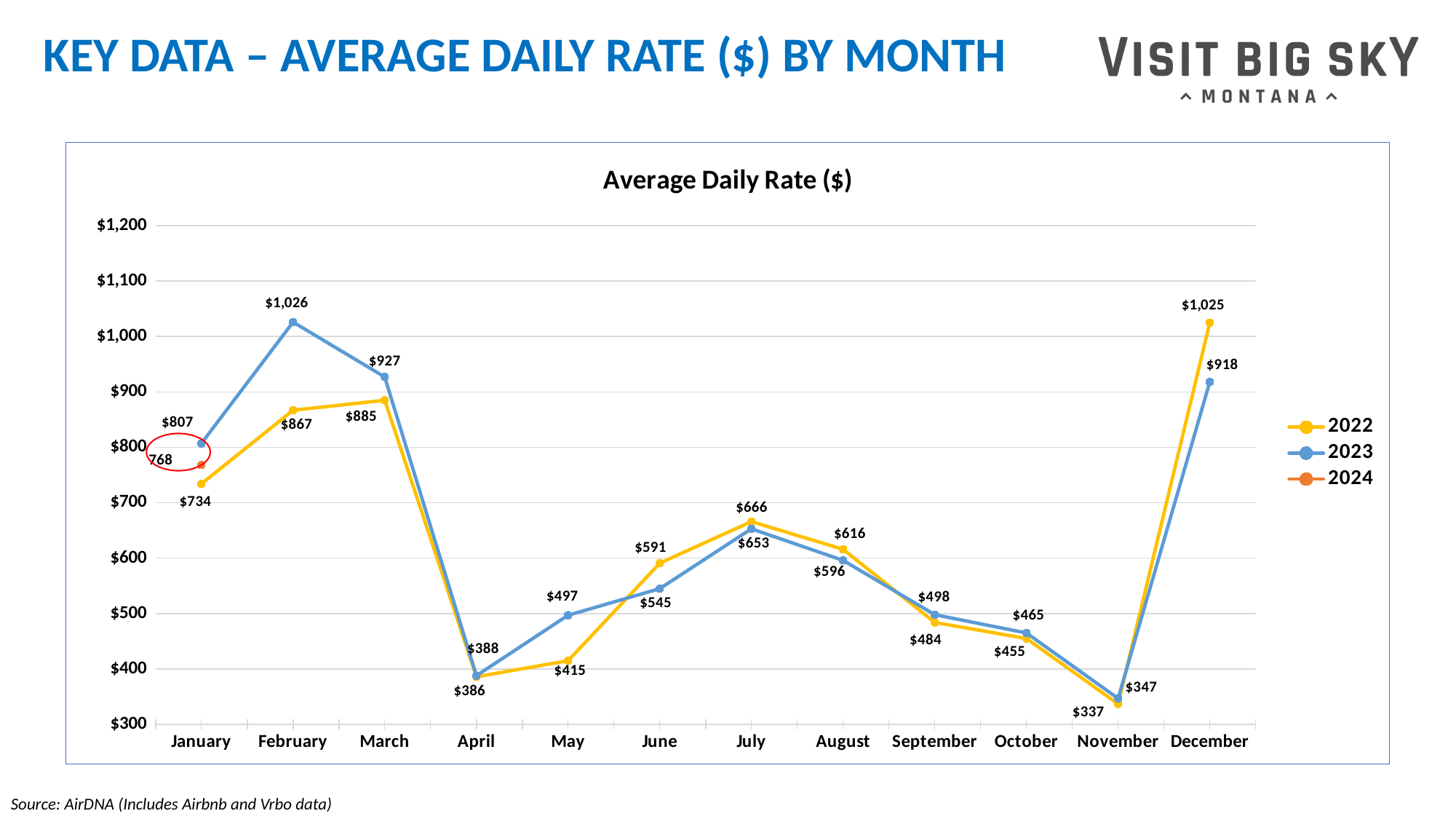
What is the title of the chart? Average Daily Rate ($) What is the 2024 value shown for January? 768 What kind of chart is shown on the slide? Line chart Does the 2022 line rise or fall from March to April? Fall How many series does the legend list? 3 What was the average daily rate for 2023 in February? $1,026 What was the average daily rate for 2022 in December? $1,025 How many months are shown on the x axis? 12 What is the difference between the 2023 and 2022 average daily rates in May? $82 In which month is the 2022 average daily rate lowest? November Which is larger in December, the 2022 value or the 2023 value? 2022 In which month is the 2023 average daily rate highest? February